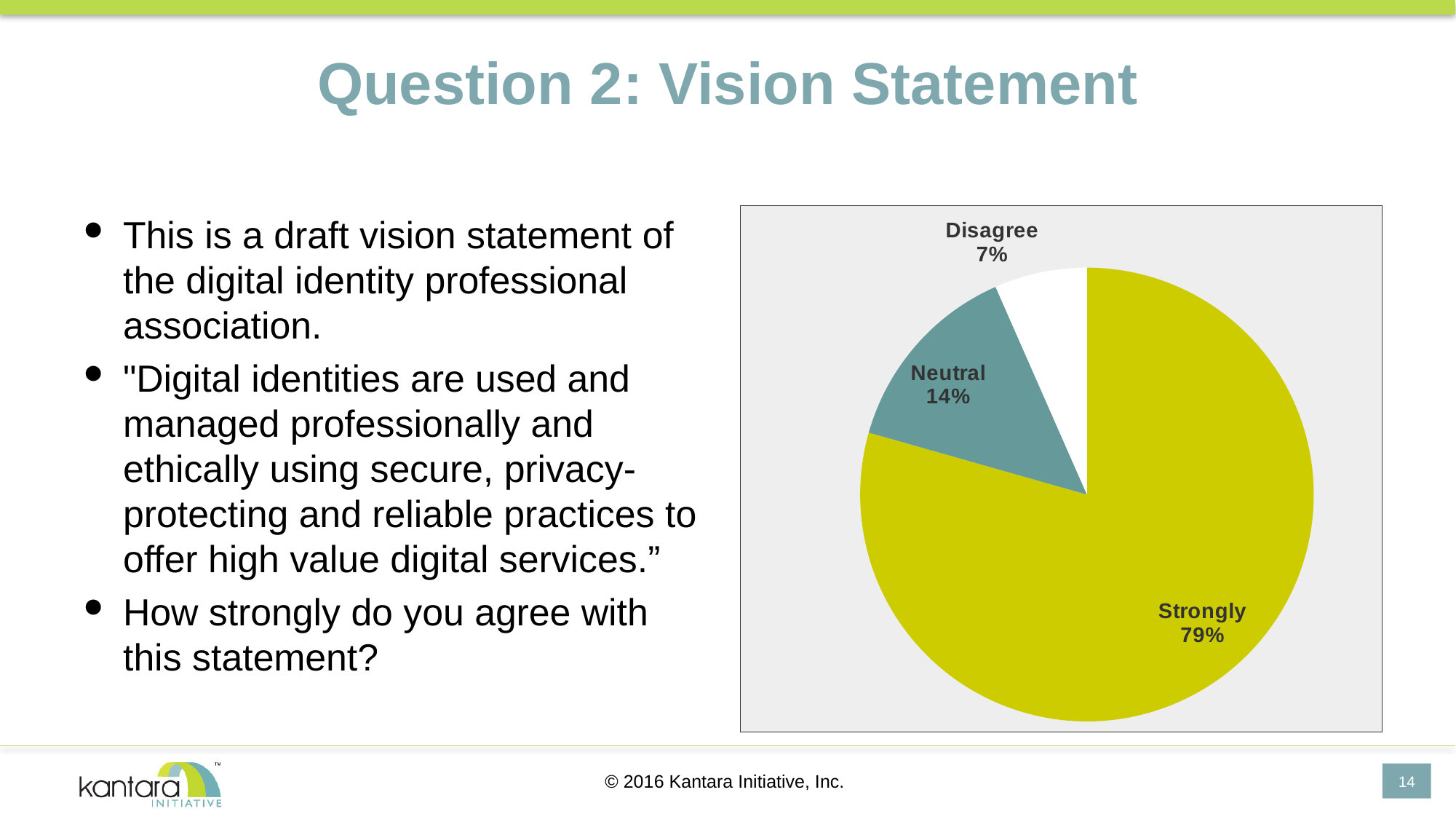
Which category has the largest slice of the pie? Strongly What share of the pie does the Neutral slice represent? 14% What is the difference in percentage points between the Strongly and Neutral slices? 65 What share of the pie does the Disagree slice represent? 7% What colour is the Strongly slice? Yellow-green Which category has the smallest slice of the pie? Disagree Which slice is larger, Neutral or Disagree? Neutral How many slices does the pie chart have? 3 What is the difference in percentage points between the Neutral and Disagree slices? 7 What kind of chart is shown on the slide? Pie chart What share of the pie does the Strongly slice represent? 79% What colour is the Neutral slice? Teal